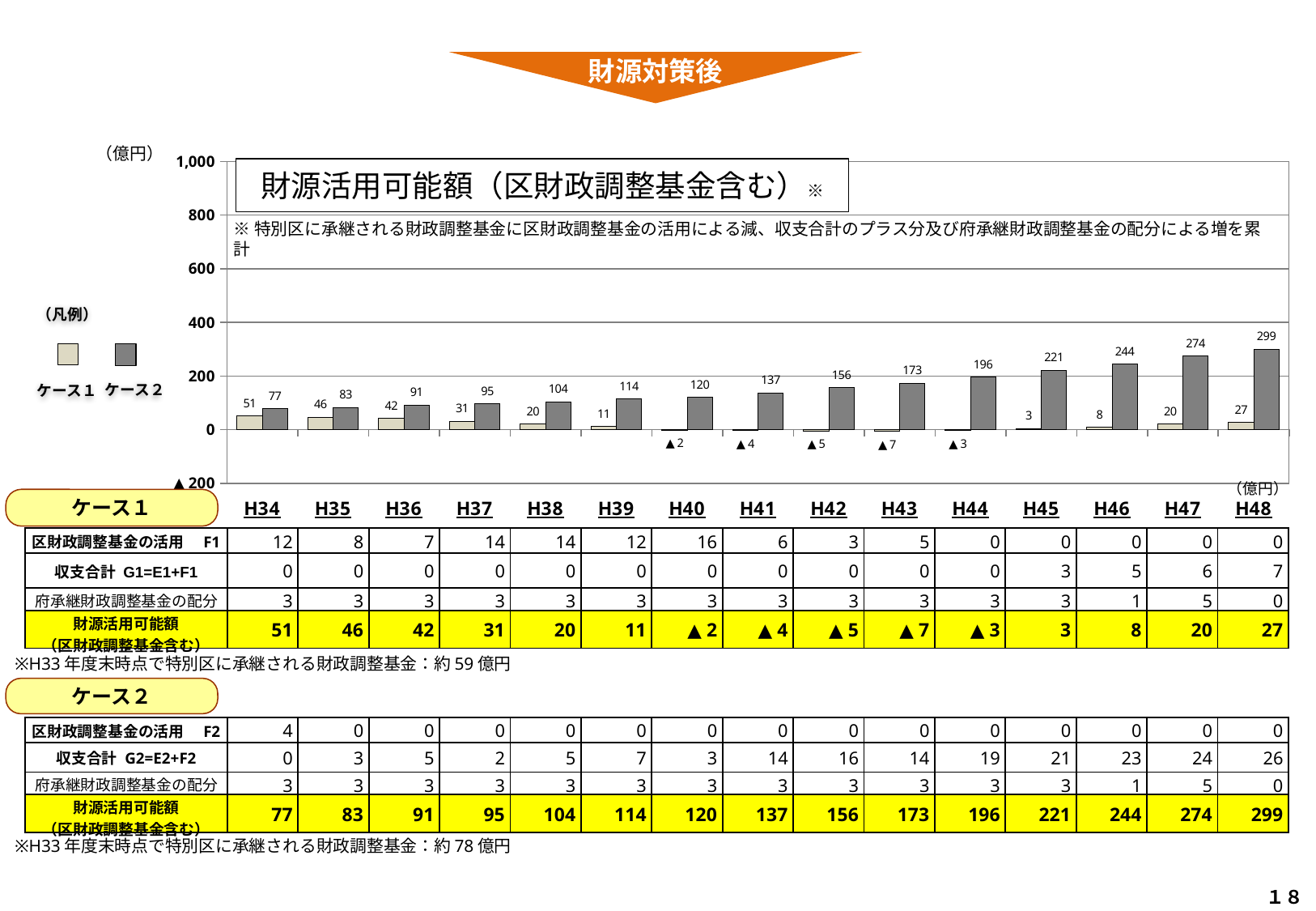
What is the difference between ケース2 and ケース1 at H34? 26 What is the value for ケース1 at H34? 51 Is the value for ケース2 at H45 greater or less than 200? greater Which is larger at H38, ケース1 or ケース2? ケース2 How many years are shown on the x axis of the chart? 15 How many series does the legend list? 2 Which year has the lowest value for ケース1? H43 What is the value for ケース1 at H43? ▲7 What kind of chart is shown? bar chart Which year has the highest value for ケース2? H48 What is the value for ケース2 at H48? 299 Do the values for ケース2 rise or fall from H34 to H48? rise